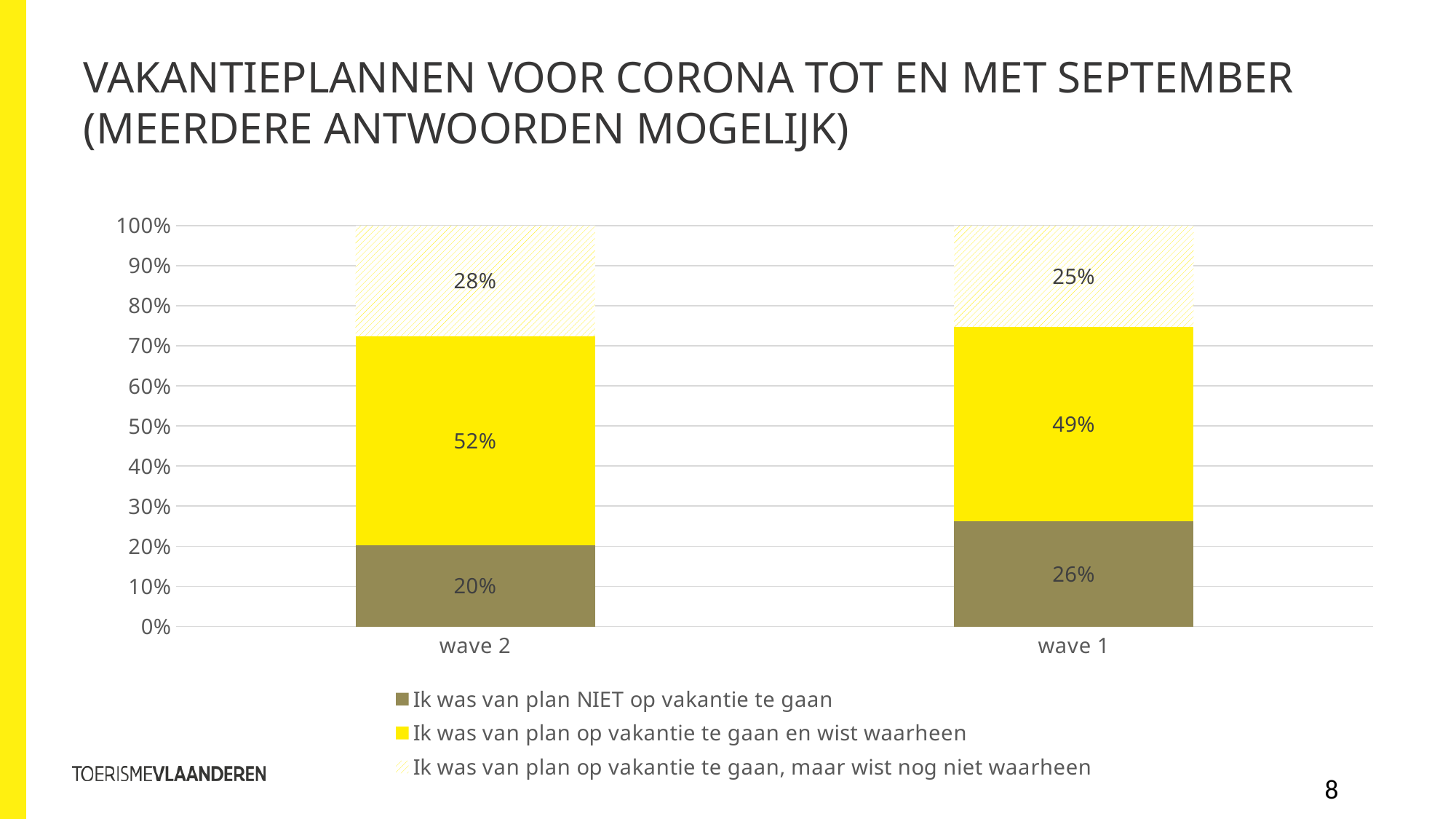
How many categories are shown on the x axis? 2 Which wave has the higher value for "Ik was van plan op vakantie te gaan en wist waarheen"? wave 2 What is the difference between wave 1 and wave 2 for "Ik was van plan NIET op vakantie te gaan"? 6 percentage points What is the difference between wave 2 and wave 1 for "Ik was van plan op vakantie te gaan, maar wist nog niet waarheen"? 3 percentage points What kind of chart is shown on the slide? Stacked bar chart What is the value for "Ik was van plan op vakantie te gaan, maar wist nog niet waarheen" in wave 2? 28% What is the value for "Ik was van plan NIET op vakantie te gaan" in wave 1? 26% Which series has the largest share in the wave 2 bar? Ik was van plan op vakantie te gaan en wist waarheen Which series has the smallest share in the wave 1 bar? Ik was van plan op vakantie te gaan, maar wist nog niet waarheen What percentage of respondents in wave 2 said they were not planning to go on holiday ("Ik was van plan NIET op vakantie te gaan")? 20% How many series does the legend list? 3 What is the value for "Ik was van plan op vakantie te gaan en wist waarheen" in wave 1? 49%